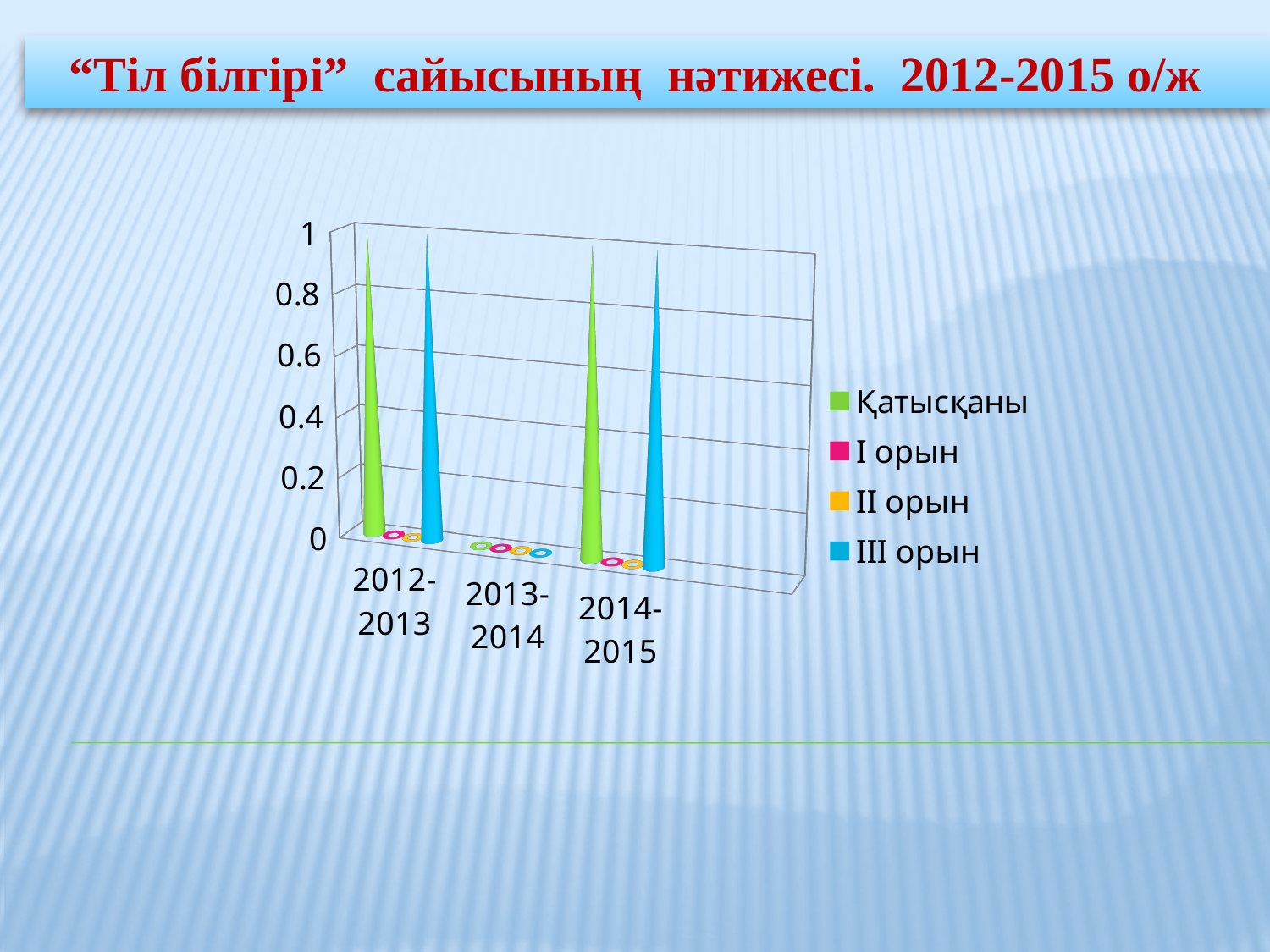
How many series does the legend list? 4 What is the value for I орын in 2012-2013? 0 Is the value for Қатысқаны in 2013-2014 greater or less than 0.2? less Which category has the lowest value for Қатысқаны? 2013-2014 Which colour represents the series "III орын" in the legend? blue What kind of chart is shown on the slide? bar chart Which is larger: Қатысқаны in 2014-2015 or II орын in 2014-2015? Қатысқаны in 2014-2015 How many categories are shown on the x axis? 3 What is the value for Қатысқаны in 2013-2014? 0 Is the value for Қатысқаны in 2012-2013 greater or less than 0.8? greater Is the value for III орын in 2014-2015 greater or less than 0.6? greater What is the title of the slide above the chart? “Тіл білгірі” сайысының нәтижесі. 2012-2015 о/ж